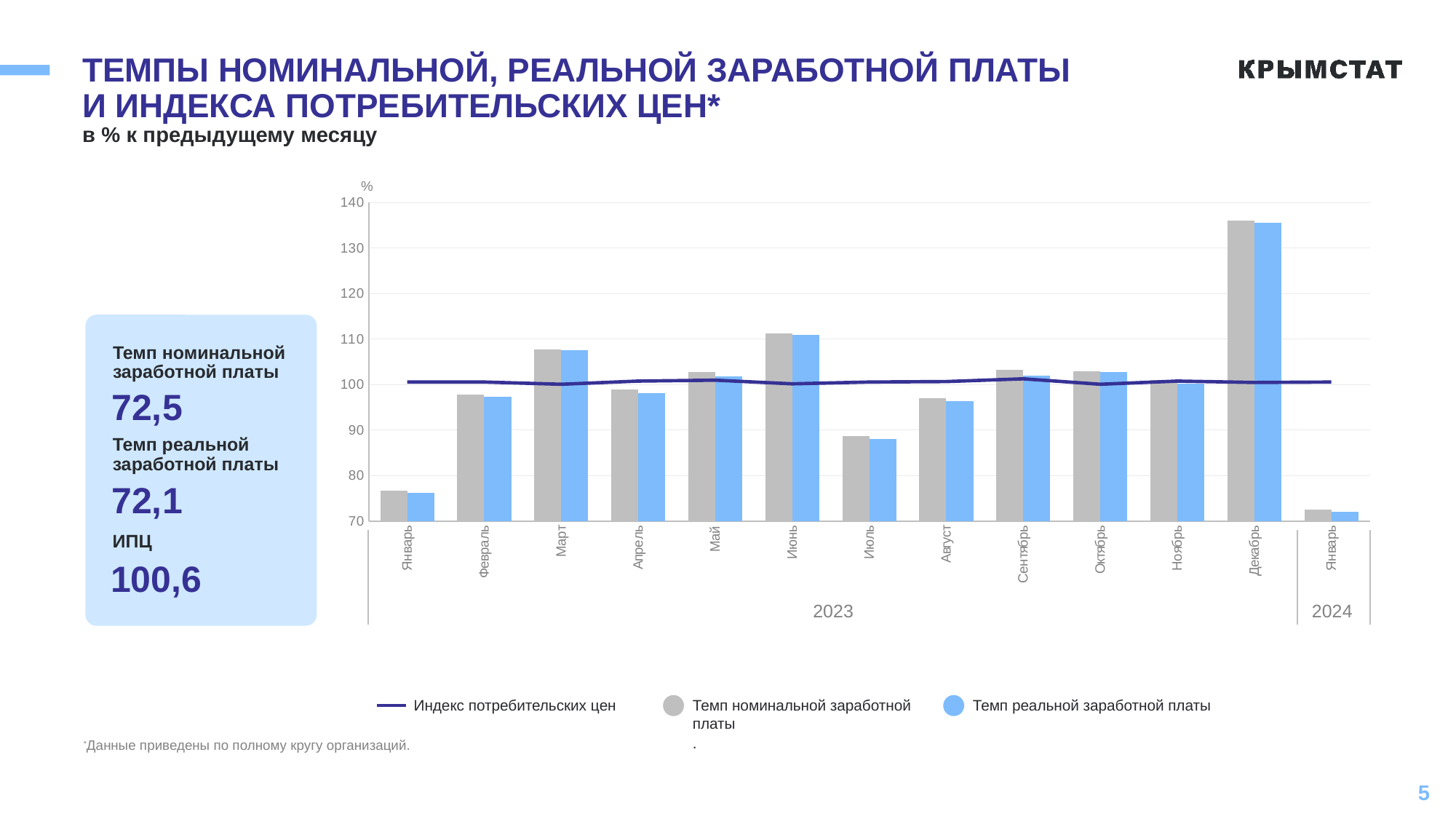
Is the value for Темп номинальной заработной платы in Декабрь 2023 greater or less than 130? greater What value does the callout box give for ИПЦ? 100,6 How many series does the legend list? 3 What value does the callout box give for Темп номинальной заработной платы? 72,5 Is the value for Темп номинальной заработной платы in Июль 2023 greater or less than 100? less How many months are shown along the x axis? 13 In which month is the value for Темп реальной заработной платы lowest? Январь 2024 In which month is the value for Темп номинальной заработной платы highest? Декабрь 2023 Is the value for Темп реальной заработной платы in Январь 2023 greater or less than 80? less What kind of chart is shown on the slide? Bar chart with a line Which is larger, the Темп номинальной заработной платы in Декабрь 2023 or in Июнь 2023? Декабрь 2023 Which series is drawn as a line rather than bars? Индекс потребительских цен